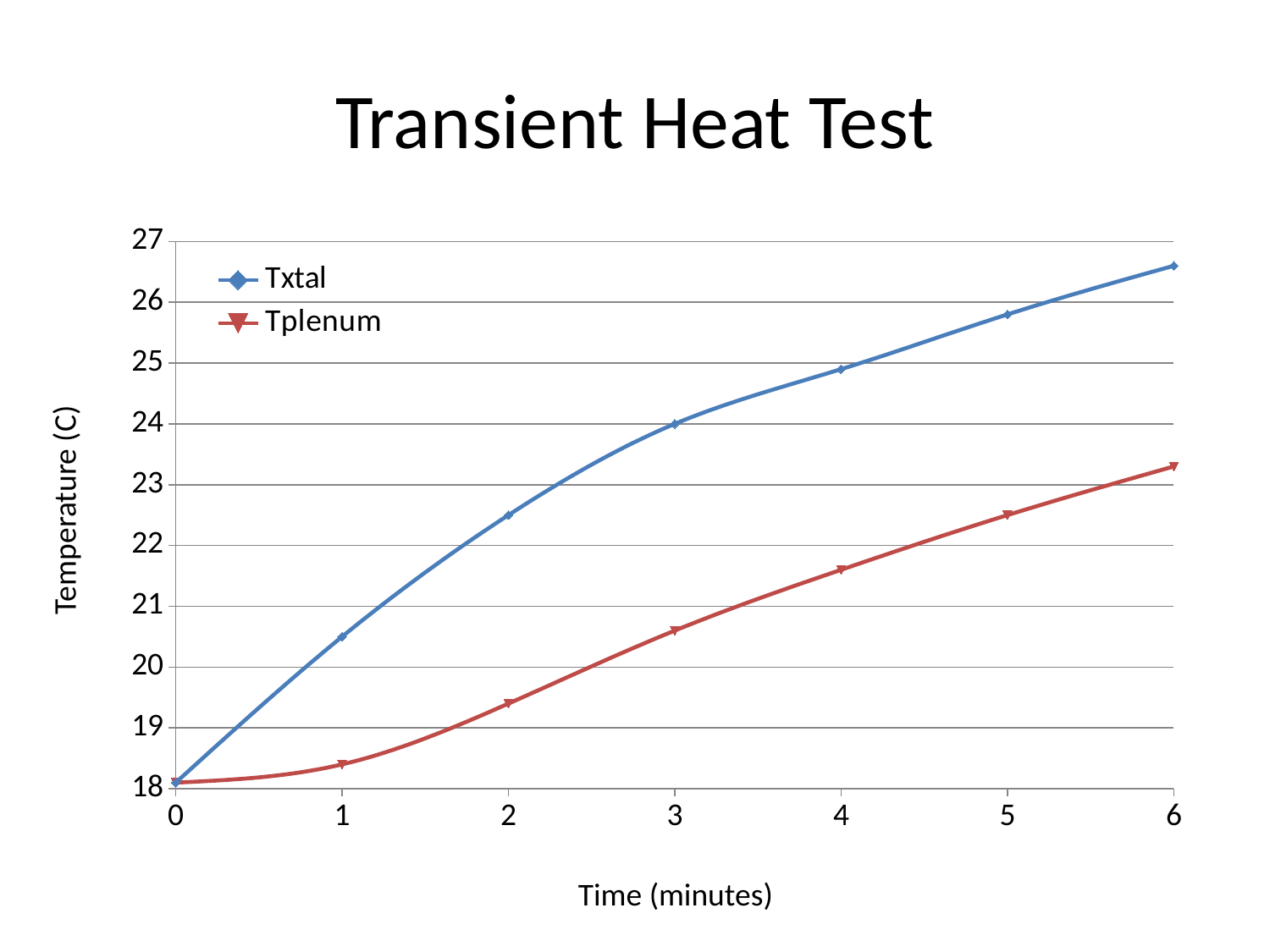
What kind of chart is shown on the slide? line chart Is the Txtal value at 6 minutes greater or less than 26? greater Is the Tplenum value at 2 minutes greater or less than 20? less At 4 minutes, which series has the higher temperature, Txtal or Tplenum? Txtal What is the label of the y axis? Temperature (C) Is the Tplenum value at 6 minutes greater or less than 23? greater What is the Txtal value at 3 minutes? 24 What is the title of the chart? Transient Heat Test Do the Tplenum values rise or fall as time increases? rise At which time does Txtal reach its highest value? 6 How many time points are plotted for each series? 7 How many series does the legend list? 2